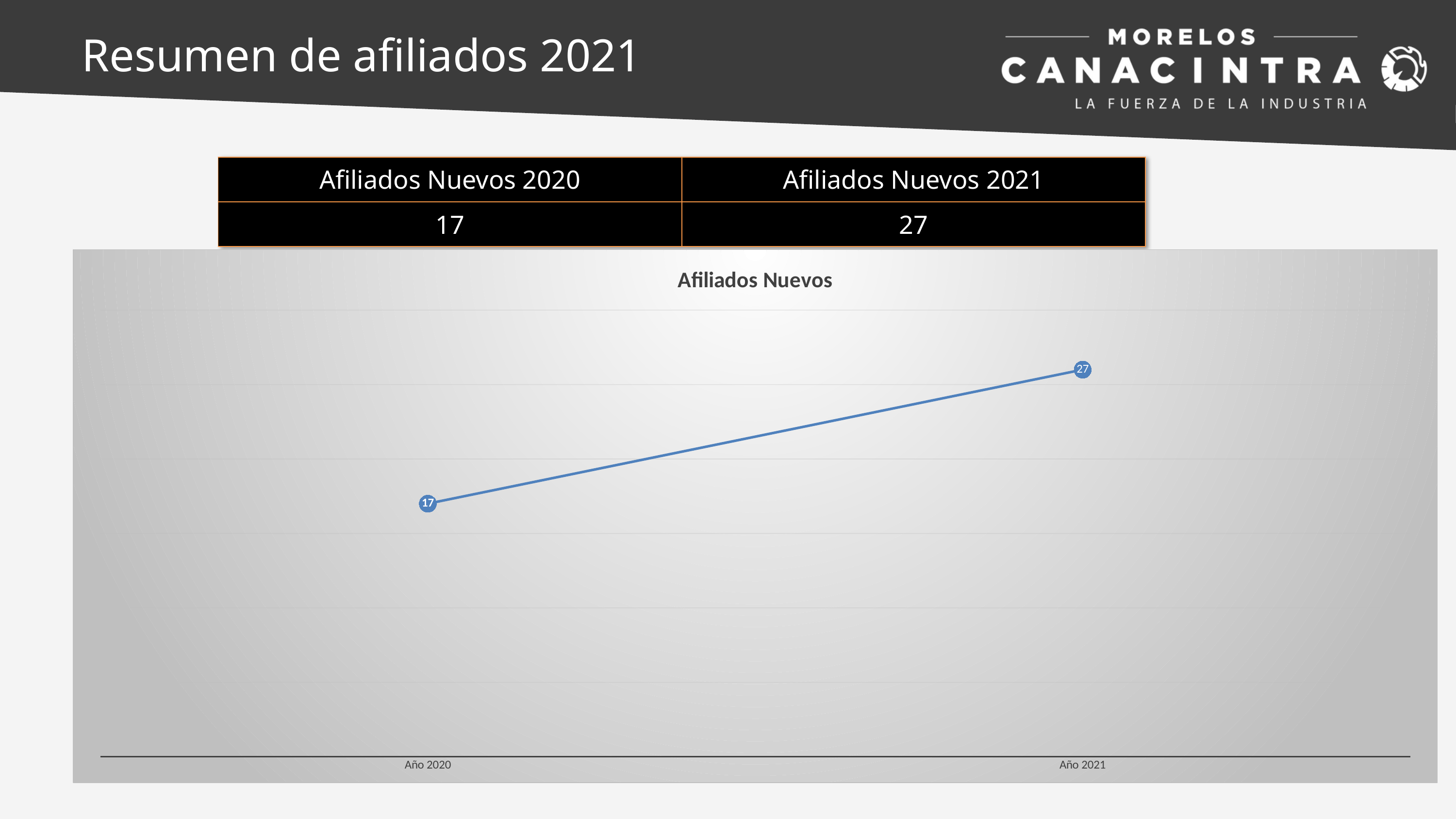
What kind of chart is the Afiliados Nuevos chart? Line chart How many data points are plotted in the Afiliados Nuevos chart? 2 What is the value for Año 2020 in the Afiliados Nuevos chart? 17 What is the difference between the values for Año 2021 and Año 2020 in the Afiliados Nuevos chart? 10 What colour is the line in the Afiliados Nuevos chart? Blue What is the value for Año 2021 in the Afiliados Nuevos chart? 27 Do the values in the Afiliados Nuevos chart rise or fall from Año 2020 to Año 2021? Rise Which is larger in the Afiliados Nuevos chart, the value for Año 2020 or Año 2021? Año 2021 Which year has the lowest value in the Afiliados Nuevos chart? Año 2020 What is the title of the chart on the slide? Afiliados Nuevos Which year has the highest value in the Afiliados Nuevos chart? Año 2021